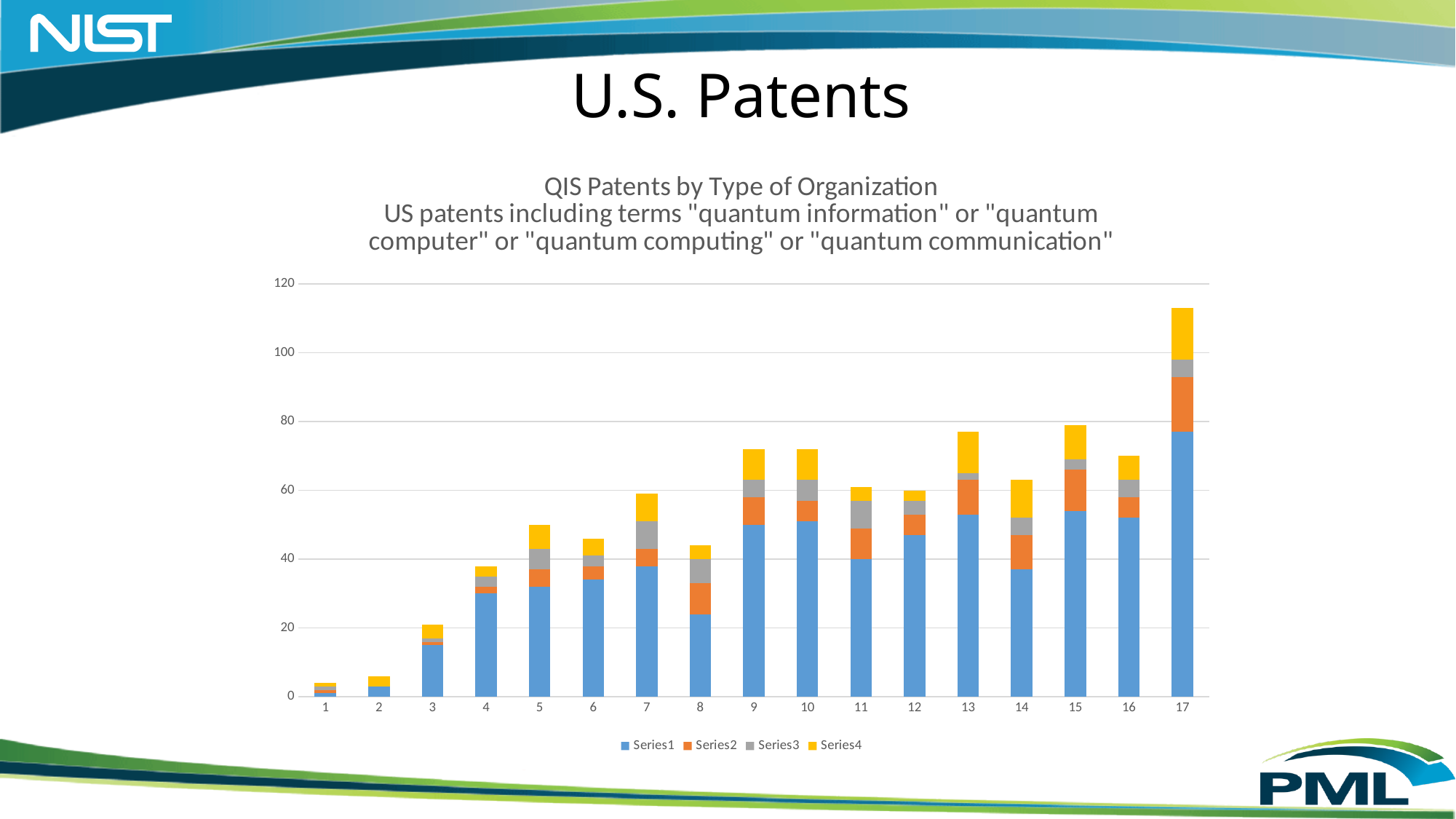
Which category has the tallest stacked bar? 17 What is the first line of the chart's title? QIS Patents by Type of Organization Do the stacked bar totals generally rise or fall from category 1 to category 17? rise Is the Series1 value for category 17 greater or less than 60? greater How many categories are shown along the x axis of the chart? 17 Is the total stacked bar for category 9 greater or less than 60? greater What kind of chart is shown on the slide? Stacked bar chart Which has the larger total stacked bar, category 15 or category 17? 17 How many series does the chart's legend list? 4 Is the total stacked bar for category 17 greater or less than 100? greater Which category has the shortest stacked bar? 1